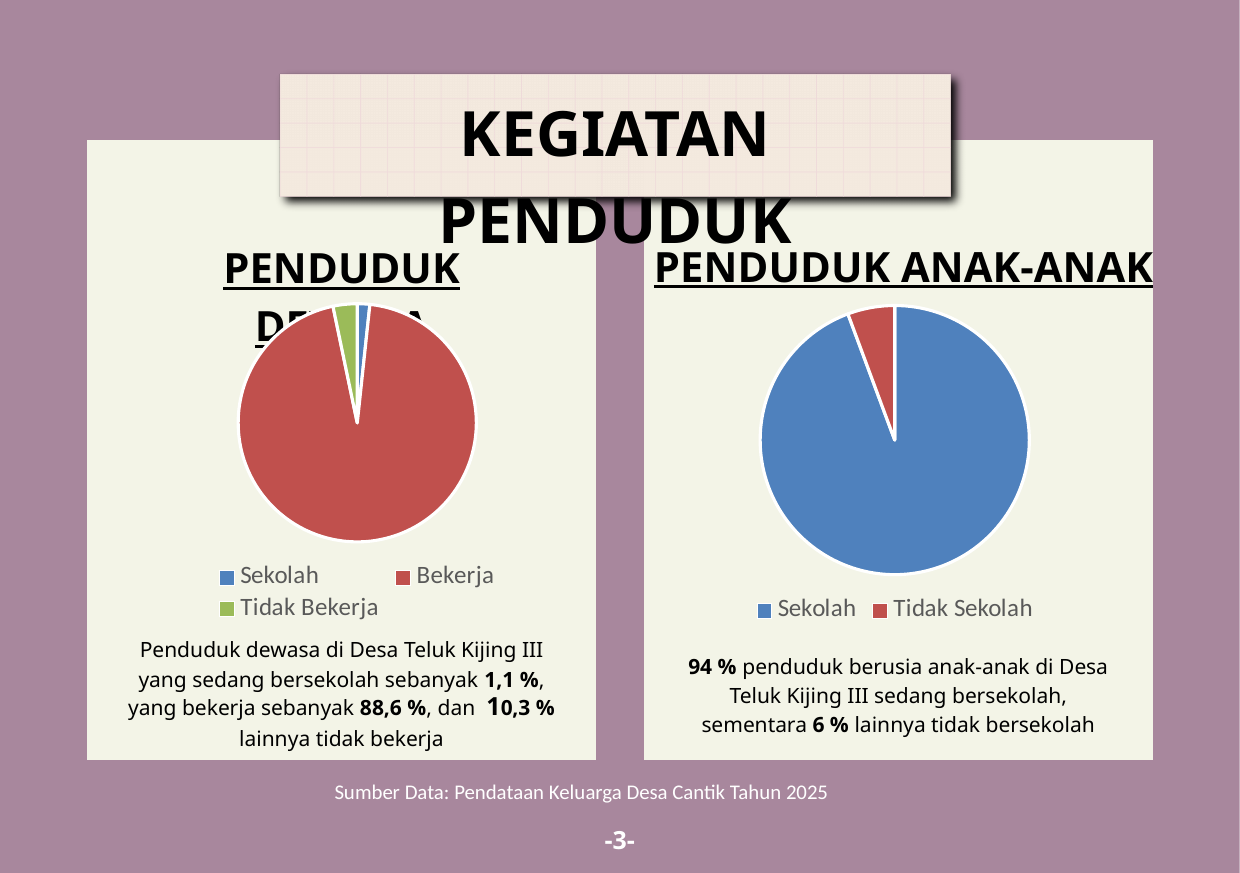
According to the slide, what share of the left pie chart is Bekerja? 88,6 % In the left pie chart, which category has the largest slice? Bekerja In the PENDUDUK ANAK-ANAK chart, which category has the largest slice? Sekolah What kind of chart is the PENDUDUK ANAK-ANAK chart? pie chart How many series does the legend of the left pie chart list? 3 What colour is the Tidak Bekerja slice in the left pie chart? green In the left pie chart, which slice is larger: Tidak Bekerja or Sekolah? Tidak Bekerja In the left pie chart, which category has the smallest slice? Sekolah How many series does the legend of the PENDUDUK ANAK-ANAK chart list? 2 In the PENDUDUK ANAK-ANAK chart, which slice is larger: Sekolah or Tidak Sekolah? Sekolah What kind of chart is the left chart on the slide? pie chart According to the slide, what share of the PENDUDUK ANAK-ANAK pie is Sekolah? 94 %